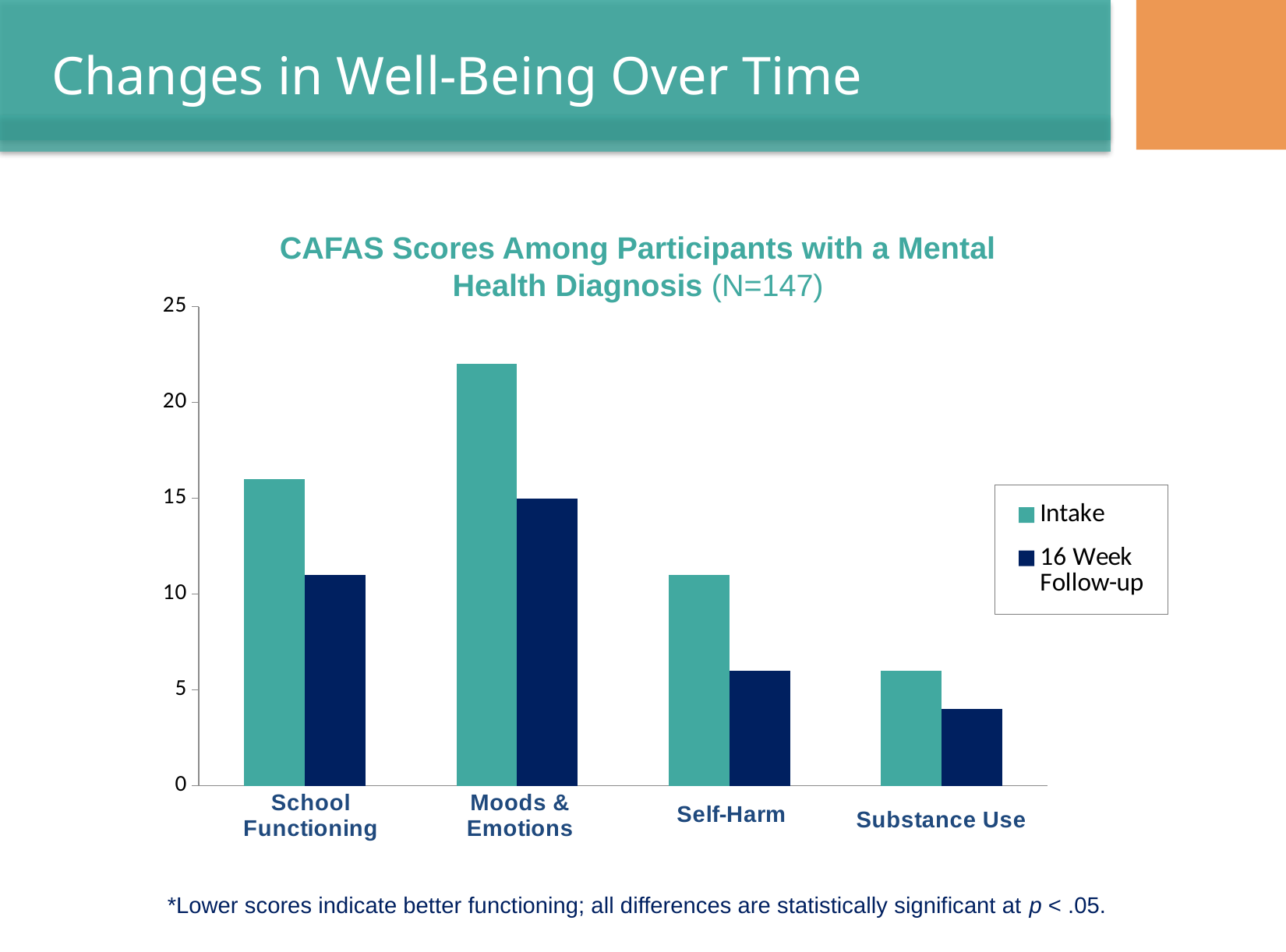
Which category has the lowest Intake score? Substance Use What kind of chart is shown on the slide? bar chart What sample size (N) is given in the chart title? N=147 Do the Intake scores rise or fall from Moods & Emotions to Substance Use along the x axis? fall Is the Intake value for School Functioning greater or less than 15? greater How many series does the legend list? 2 Is the Intake value for Moods & Emotions greater or less than 20? greater Which category has the highest Intake score? Moods & Emotions How many categories are shown along the x axis? 4 For Self-Harm, which is larger: the Intake score or the 16 Week Follow-up score? Intake Is the 16 Week Follow-up value for Self-Harm greater or less than 10? less Which category has the lowest 16 Week Follow-up score? Substance Use